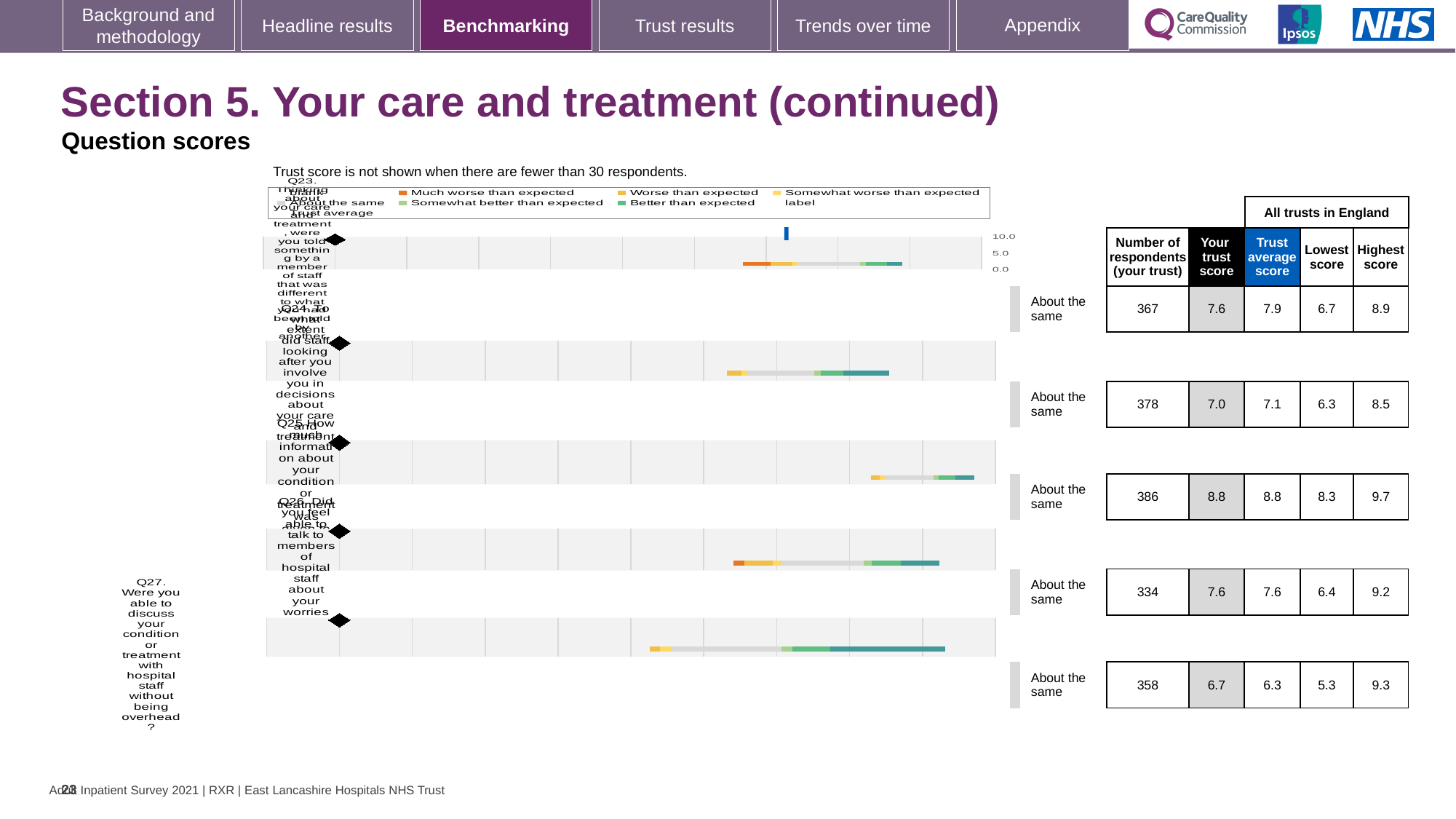
What is the trust average score for Q23? 7.9 For Q27, what is the difference between the highest score and the lowest score across all trusts in England? 4.0 Which question has the lowest 'Your trust score'? Q27 What kind of chart is used to show the question scores on this slide? bar chart How many questions (Q23 to Q27) are plotted in the chart? 5 For Q24, which is larger: your trust score or the trust average score? Trust average score What is the 'Your trust score' value for Q27? 6.7 How many respondents (your trust) are shown for Q25? 386 Which question has the highest 'Your trust score'? Q25 What is the lowest score across all trusts in England for Q24? 6.3 What benchmark label is shown next to the bar for Q23? About the same Which question has the largest number of respondents? Q25